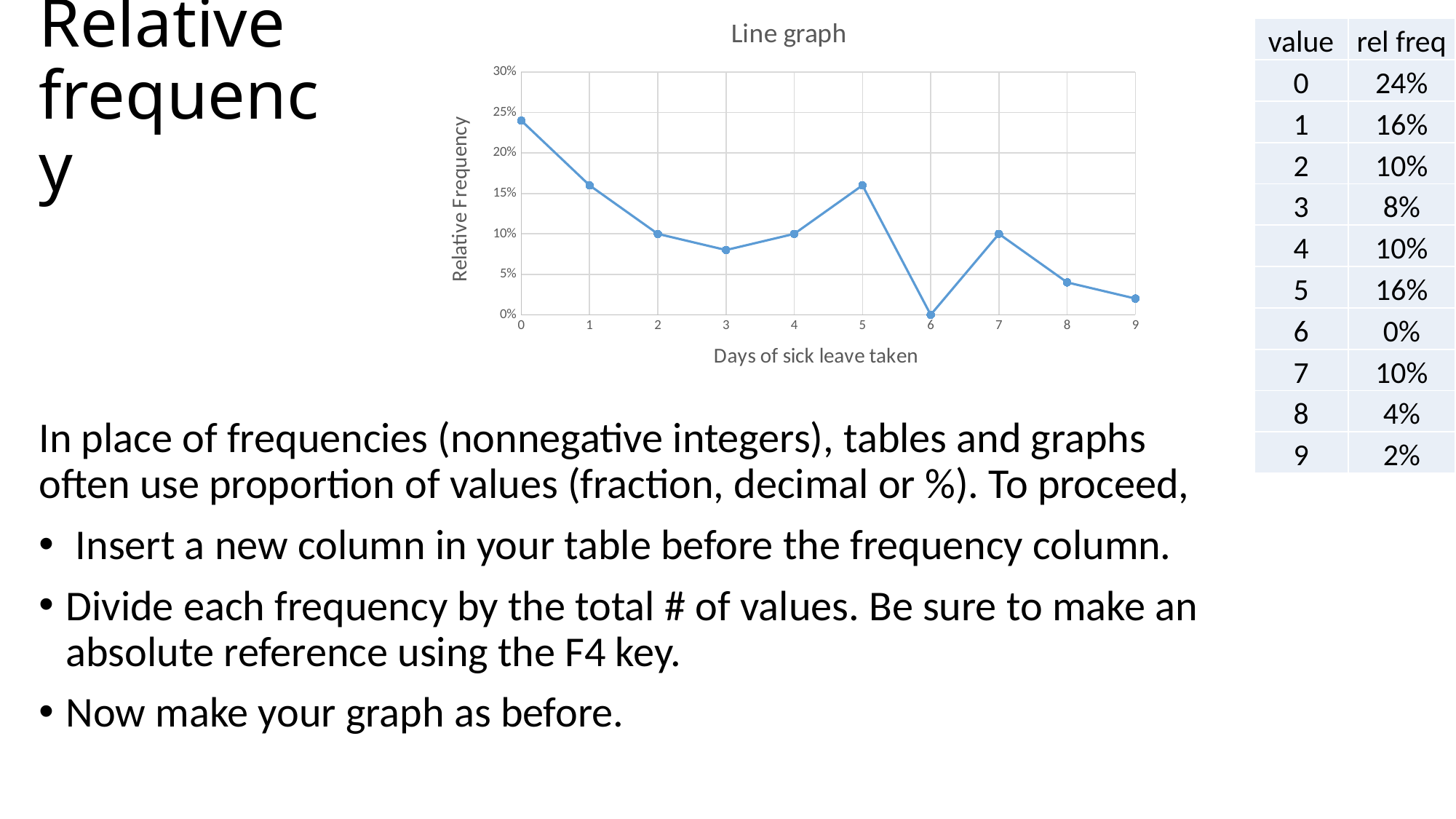
Which has a higher relative frequency, 3 days or 5 days of sick leave? 5 days What type of chart is shown on the slide? line chart What is the x-axis label of the chart? Days of sick leave taken Is the relative frequency for 8 days of sick leave greater or less than 5%? less What is the relative frequency for 5 days of sick leave taken? 16% Which number of days of sick leave has the lowest relative frequency? 6 What is the title of the chart? Line graph How many data points are plotted on the line chart? 10 What is the difference between the relative frequency for 0 days and for 1 day of sick leave? 8% Which number of days of sick leave has the highest relative frequency? 0 What is the relative frequency for 0 days of sick leave taken? 24% What is the relative frequency for 6 days of sick leave taken? 0%